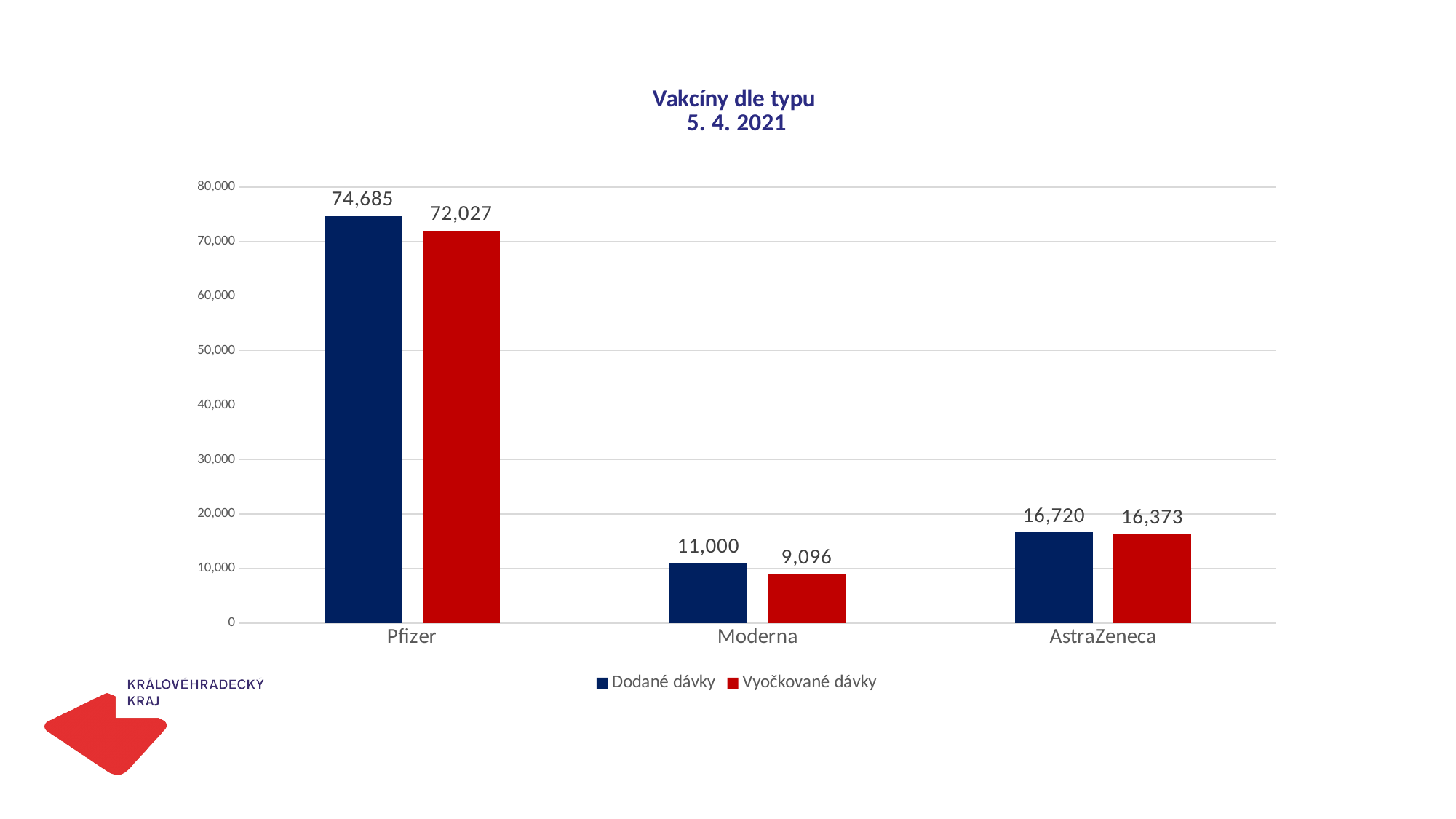
What is the title of the chart? Vakcíny dle typu 5. 4. 2021 What is the value of Vyočkované dávky for Moderna? 9,096 How many vaccine types are shown on the x axis? 3 Which vaccine type has the highest Vyočkované dávky value? Pfizer What kind of chart is shown on the slide? Bar chart What is the difference between Dodané dávky and Vyočkované dávky for Pfizer? 2,658 Which vaccine type has the lowest Dodané dávky value? Moderna What is the value of Dodané dávky for Pfizer? 74,685 How many series does the legend list? 2 Which is larger: Dodané dávky for AstraZeneca or Dodané dávky for Moderna? Dodané dávky for AstraZeneca What is the difference between Dodané dávky and Vyočkované dávky for Moderna? 1,904 What is the value of Dodané dávky for AstraZeneca? 16,720